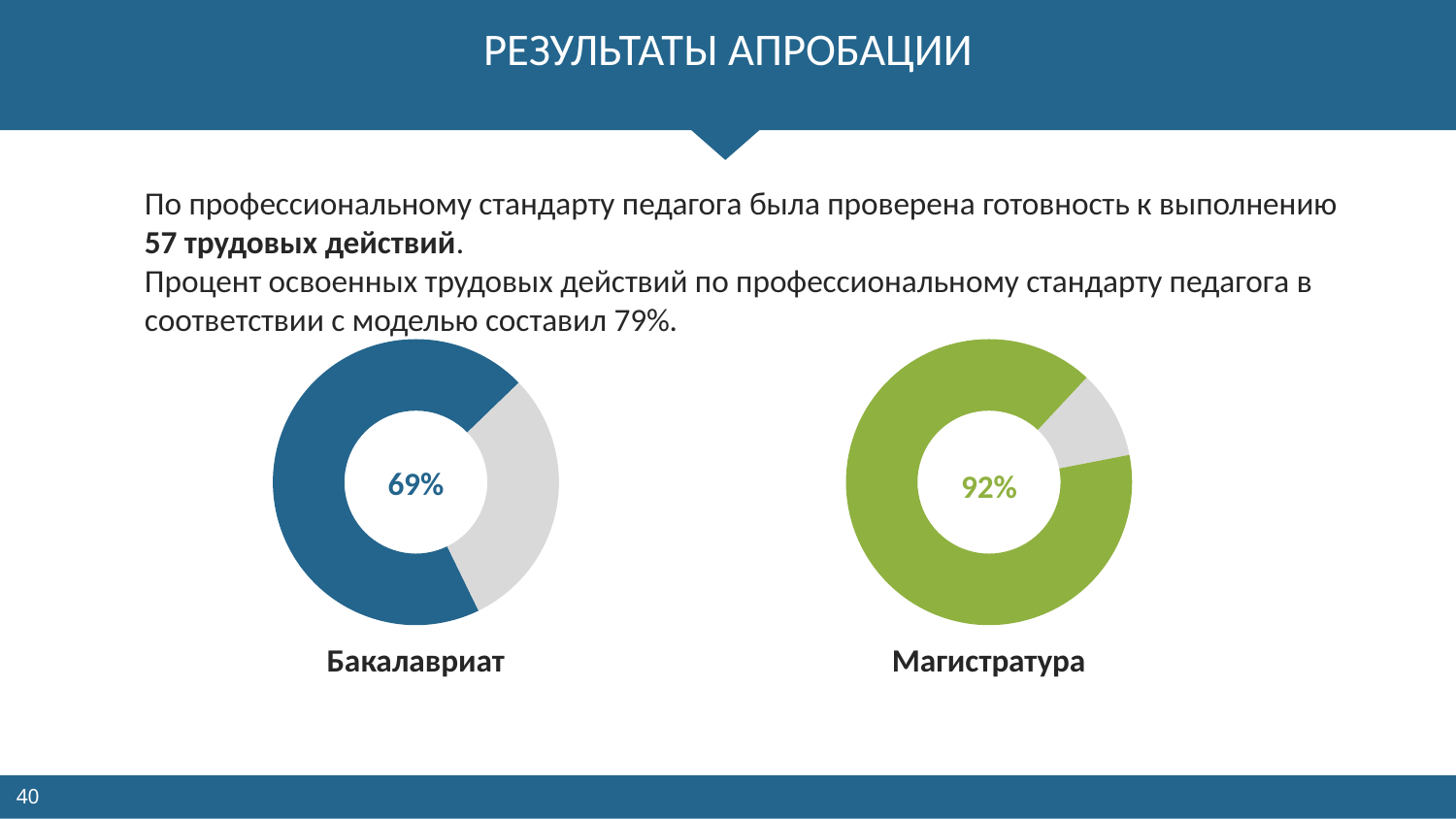
What colour is the filled portion of the Магистратура donut chart? Green Which of the two charts shows the lower percentage, Бакалавриат or Магистратура? Бакалавриат How many donut charts are shown on the slide? 2 What kind of chart is used for Бакалавриат? Donut (pie) chart In the Бакалавриат chart, what percentage is shown in the centre of the donut? 69% Is the value in the Бакалавриат chart greater or less than 50%? greater Which of the two charts shows the higher percentage, Бакалавриат or Магистратура? Магистратура What is the difference in percentage points between the Магистратура value and the Бакалавриат value? 23 In the Магистратура chart, what percentage is shown in the centre of the donut? 92% Is the value in the Магистратура chart greater or less than 90%? greater What colour is the filled portion of the Бакалавриат donut chart? Blue